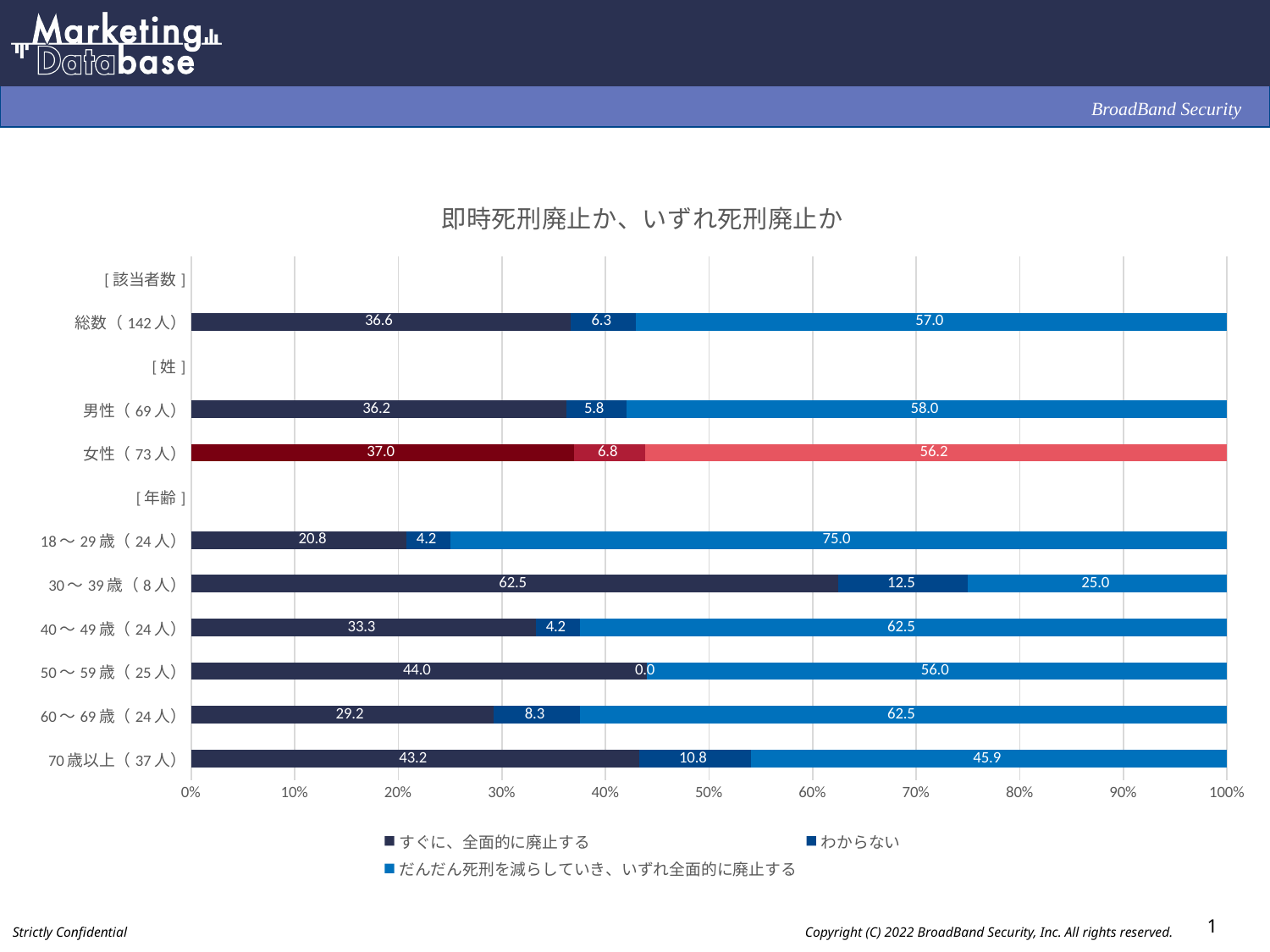
Which category has the lowest value for わからない? 50～59歳 (25人) What is the value of わからない for 70歳以上 (37人)? 10.8 Which bar is drawn in red shades instead of blue? 女性 (73人) What is the value of すぐに、全面的に廃止する for 総数 (142人)? 36.6 Which age group has the highest value for すぐに、全面的に廃止する? 30～39歳 (8人) What type of chart is shown on the slide? Stacked bar chart Which is larger: the だんだん死刑を減らしていき、いずれ全面的に廃止する value for 男性 (69人) or for 女性 (73人)? 男性 (69人) How many series does the legend list? 3 What is the difference between the すぐに、全面的に廃止する values for 女性 (73人) and 男性 (69人)? 0.8 What is the value of だんだん死刑を減らしていき、いずれ全面的に廃止する for 18～29歳 (24人)? 75.0 How many data bars (categories with plotted values) are shown in the chart? 9 What is the title of the chart? 即時死刑廃止か、いずれ死刑廃止か